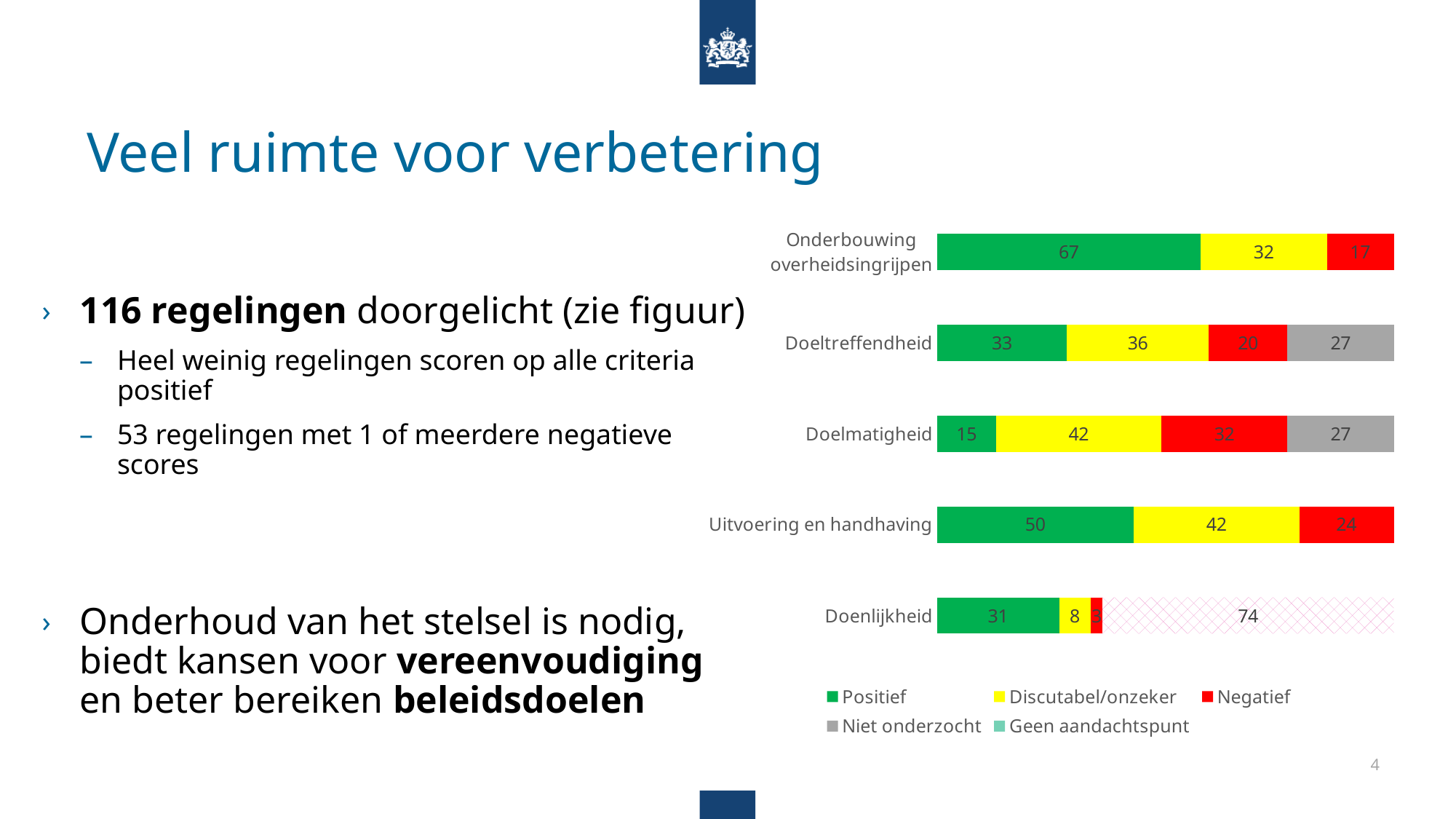
What is the Geen aandachtspunt value for Doenlijkheid? 74 What is the difference between the Discutabel/onzeker values for Doelmatigheid and Doeltreffendheid? 6 How many series does the chart legend list? 5 Which category has the lowest Positief value? Doelmatigheid Which is larger: the Negatief value for Uitvoering en handhaving or for Doeltreffendheid? Uitvoering en handhaving What is the Niet onderzocht value for Doeltreffendheid? 27 What is the Positief value for Onderbouwing overheidsingrijpen? 67 What is the total of the stacked bar for Uitvoering en handhaving? 116 Which category has the highest Positief value? Onderbouwing overheidsingrijpen What is the Negatief value for Doelmatigheid? 32 What type of chart is shown on the slide? Stacked bar chart How many categories are shown on the chart? 5